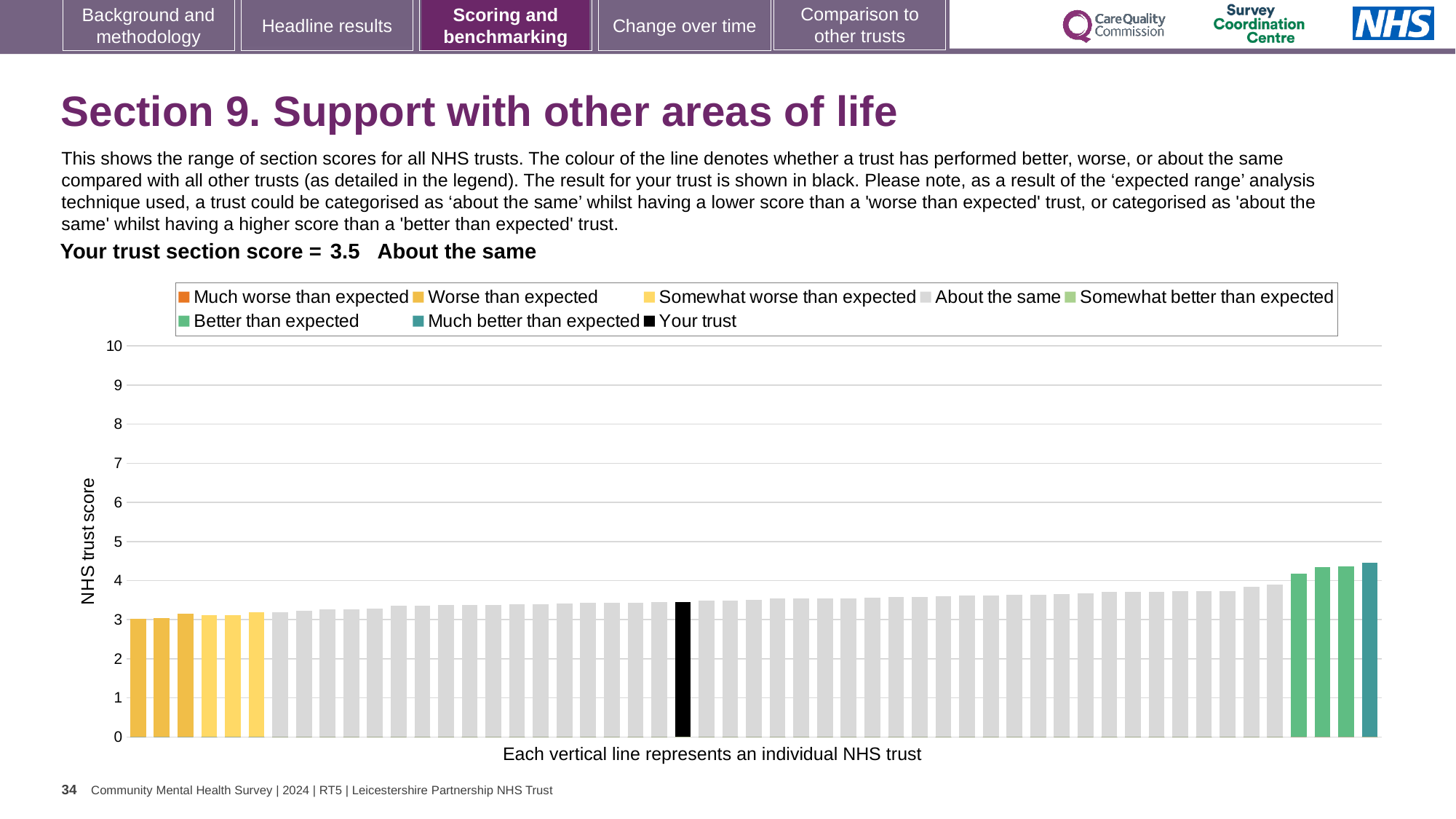
What kind of chart is shown on the slide? Bar chart What colour is the bar representing your trust? Black How many bars are coloured as 'Worse than expected' (gold) at the left of the chart? 3 Do the bar values rise or fall moving from left to right along the x axis? rise How many entries does the chart legend list? 8 Is the value of the highest bar (rightmost) greater or less than 4? greater Is the value of the black 'Your trust' bar greater or less than 3? greater What is the label on the vertical axis of the chart? NHS trust score What is the section score for your trust shown on the slide? 3.5 Is the value of the lowest bar (leftmost) greater or less than 4? less Which performance category does the highest-scoring trust (rightmost bar) belong to, according to the legend colours? Much better than expected